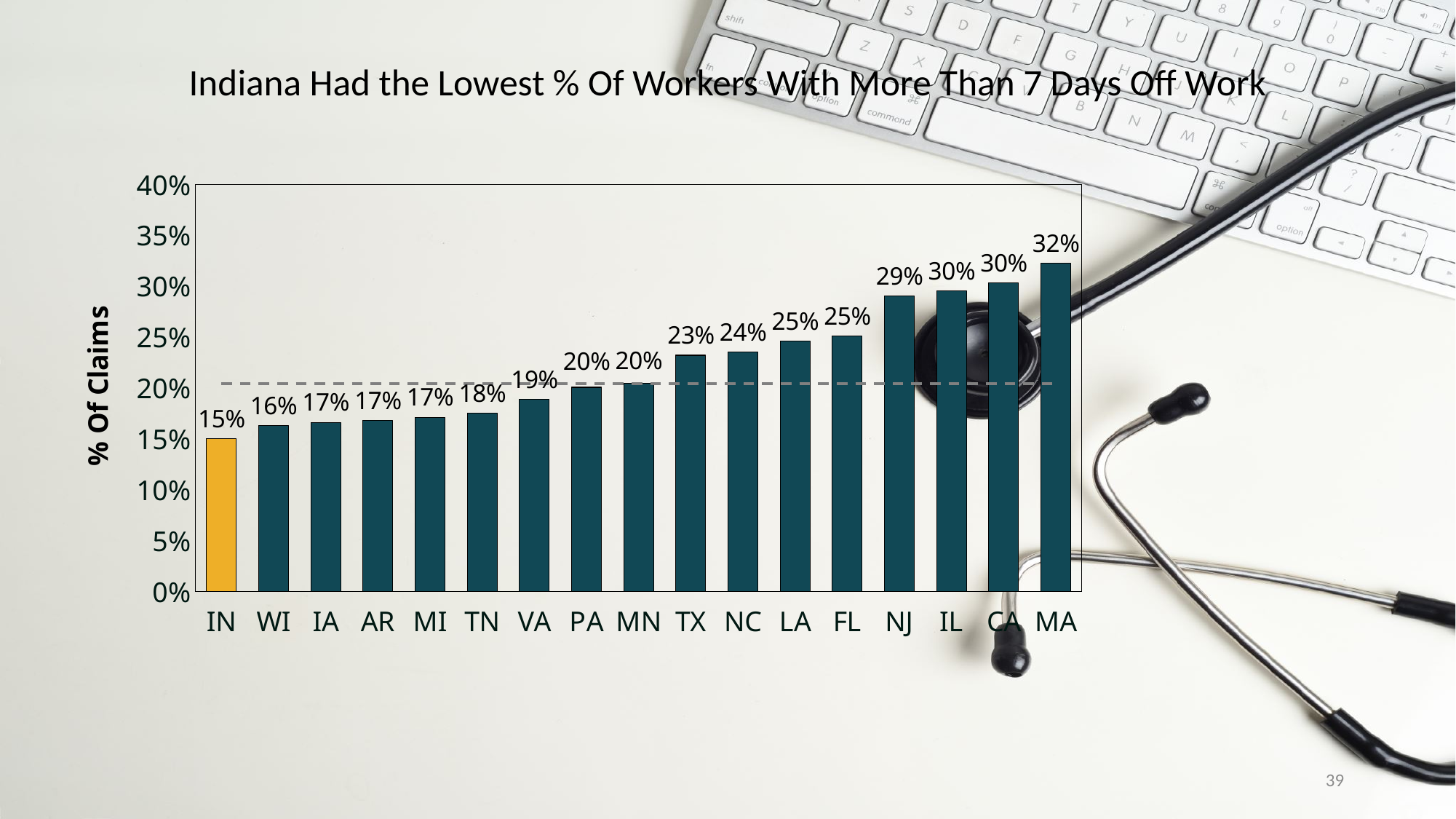
Do the values rise or fall from left to right along the x axis? rise What is the value for TX? 23% Is the value for FL greater or less than 20%? greater Which state has the highest % of claims? MA What is the difference between the values for MA and IN? 17% What kind of chart is shown on the slide? bar chart What is the title of the chart? Indiana Had the Lowest % Of Workers With More Than 7 Days Off Work Which is larger, the value for VA or the value for LA? LA What is the value for NJ? 29% What is the value for IN? 15% Which state has the lowest % of claims? IN How many states are shown on the x axis? 17